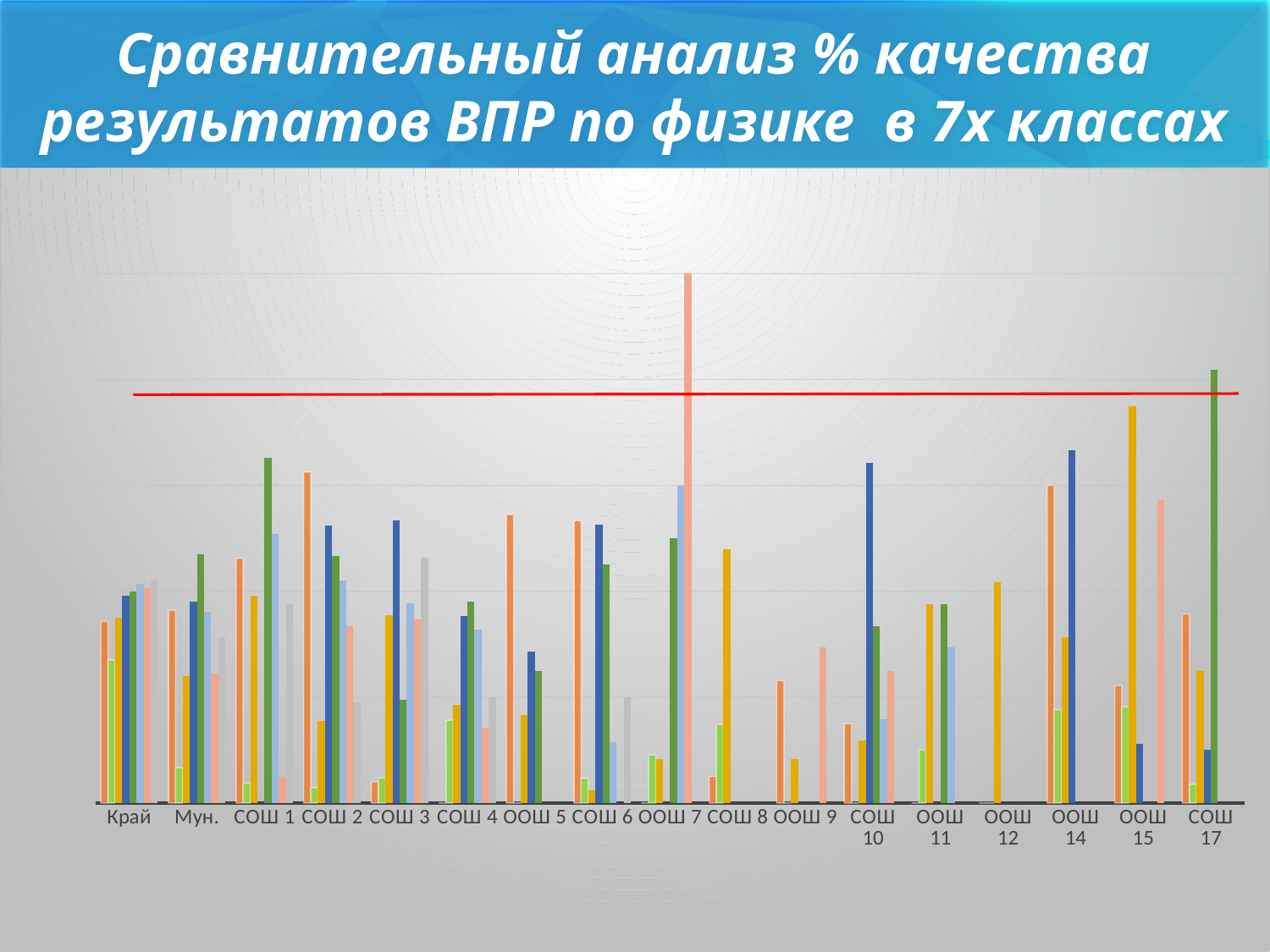
Which category has the taller tallest bar: ООШ 7 or ООШ 9? ООШ 7 What is the last category label on the x axis of the chart? СОШ 17 How many categories are shown along the x axis of the chart? 17 What kind of chart is shown on the slide? bar chart Which category has the taller tallest bar: СОШ 17 or ООШ 12? СОШ 17 What is the first category label on the x axis of the chart? Край Which category on the x axis contains the tallest bar in the chart? ООШ 7